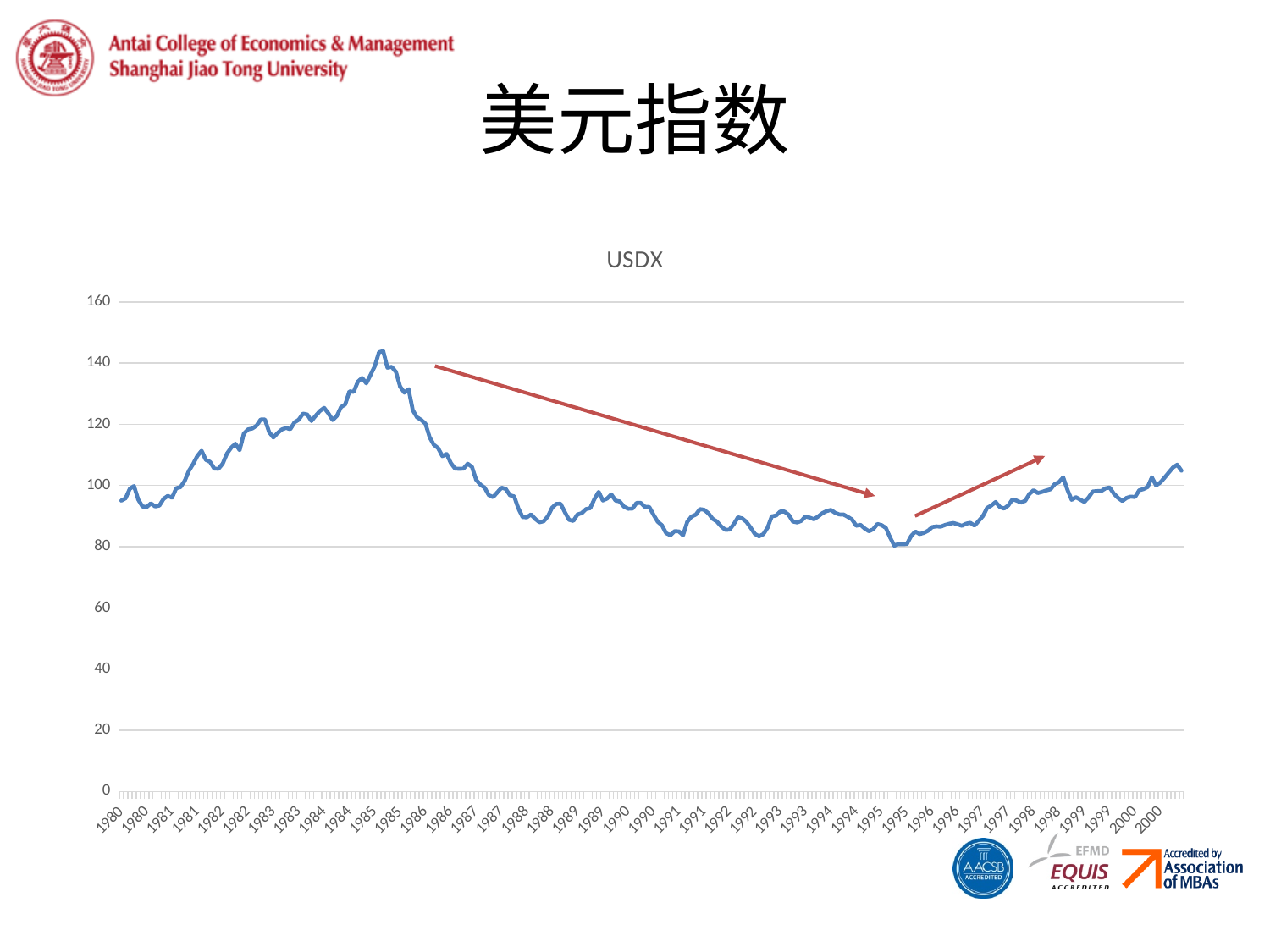
What kind of chart is shown on the slide? line chart Is the peak value of the USDX line in 1985 greater or less than 120? greater Is the lowest value of the USDX line around 1995 greater or less than 100? less Does the USDX line rise or fall between its 1985 peak and 1995? fall Which is larger, the USDX value at its 1985 peak or its value at the 1995 low? 1985 peak In which year does the USDX line reach its highest point? 1985 In which year does the USDX line reach its lowest point? 1995 What is the title of the chart? USDX Does the USDX line rise or fall between 1995 and 2000? rise Is the value of the USDX line at the end of 2000 greater or less than 80? greater How many lines are plotted on the chart? 1 What is the highest value shown on the vertical axis of the chart? 160